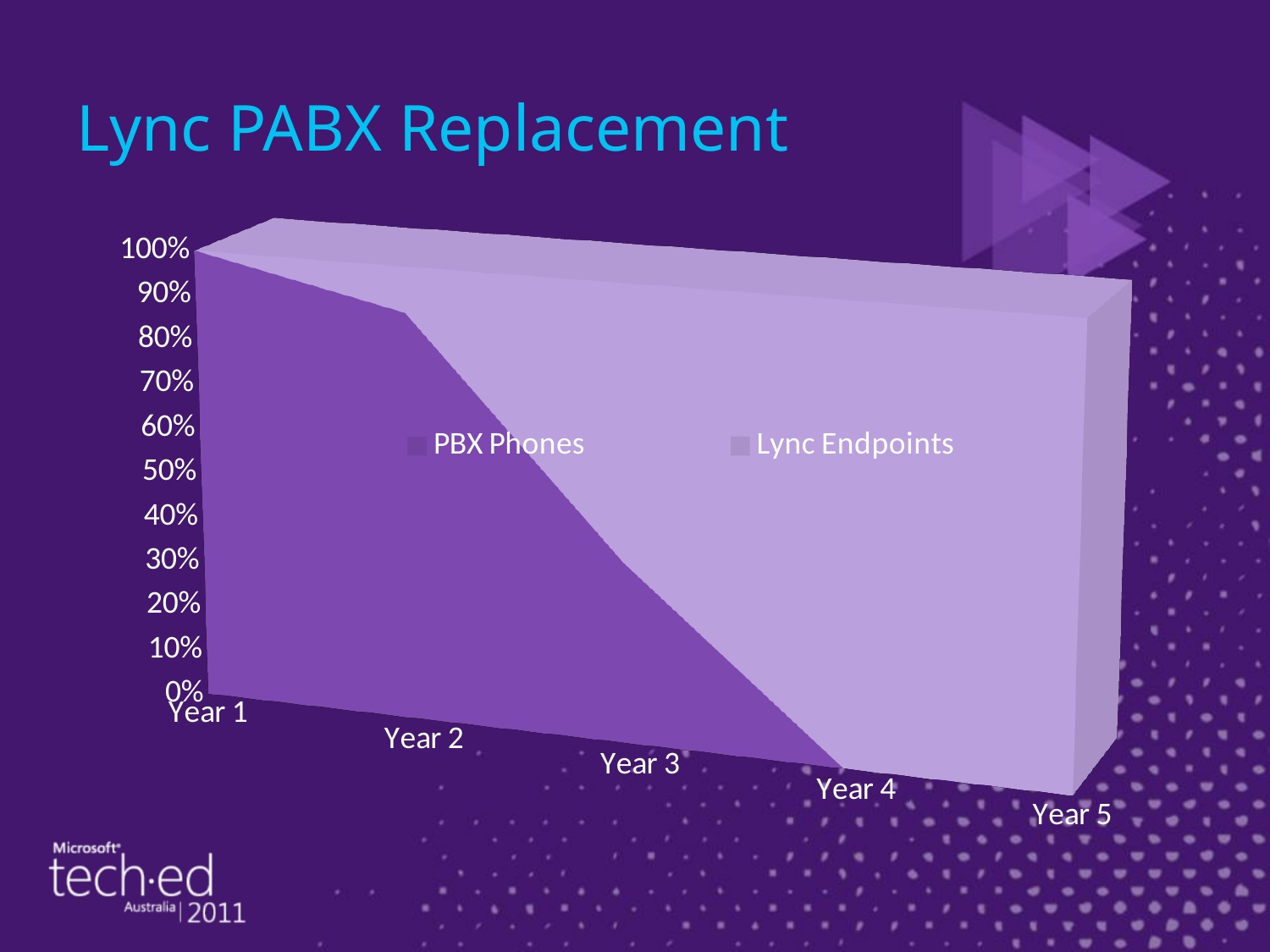
In Year 1, which series has the larger share, PBX Phones or Lync Endpoints? PBX Phones What kind of chart is shown on the slide? area chart Does the share of PBX Phones rise or fall from Year 1 to Year 5? fall In which year is the share of PBX Phones highest? Year 1 What is the title of the chart? Lync PABX Replacement Does the share of Lync Endpoints rise or fall from Year 1 to Year 5? rise What are the two series named in the legend? PBX Phones and Lync Endpoints Is the share of PBX Phones in Year 3 greater or less than 70%? less How many series does the legend list? 2 How many years are shown along the x axis? 5 In Year 4, which series has the larger share, PBX Phones or Lync Endpoints? Lync Endpoints Is the share of PBX Phones in Year 2 greater or less than 50%? greater